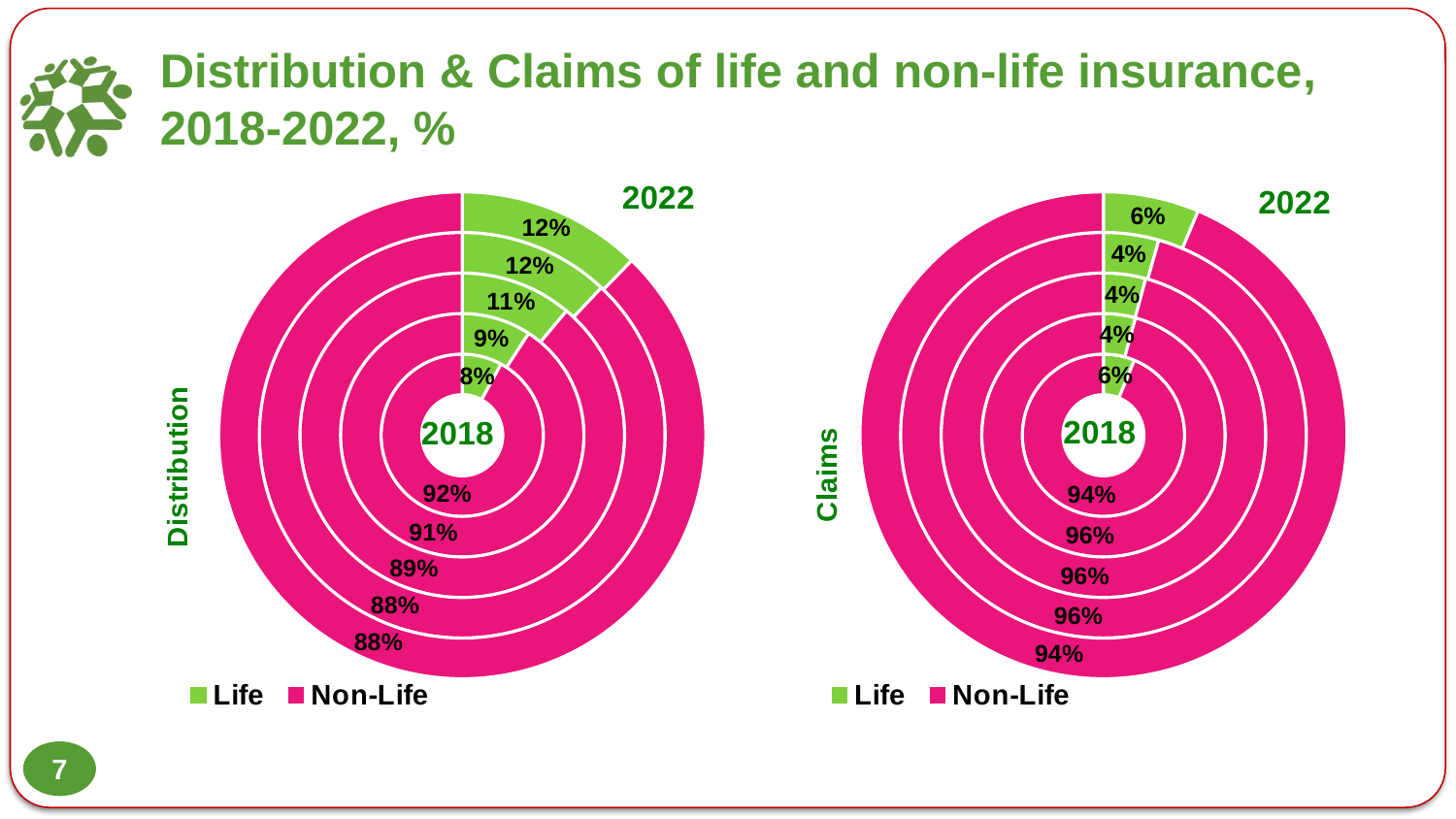
How many series does the legend of the Claims chart list? 2 How many rings (years) does the Distribution chart show? 5 In the Distribution chart, what is the Life share in the outermost ring (2022)? 12% In the Claims chart, what is the Non-Life share in the middle ring? 96% In the Distribution chart, what is the difference between the Non-Life and Life shares in the innermost ring (2018)? 84 percentage points In the Distribution chart, what is the Life share in the innermost ring (2018)? 8% In the Claims chart, what is the Life share in the outermost ring (2022)? 6% Which chart shows the larger Life share in the outermost ring (2022), Distribution or Claims? Distribution In the Distribution chart, does the Life share rise or fall from the innermost ring (2018) to the outermost ring (2022)? Rises In the Claims chart, what is the Non-Life share in the innermost ring (2018)? 94% What kind of chart is used for the Distribution data on the left? Doughnut chart In the Distribution chart, what is the Non-Life share in the innermost ring (2018)? 92%